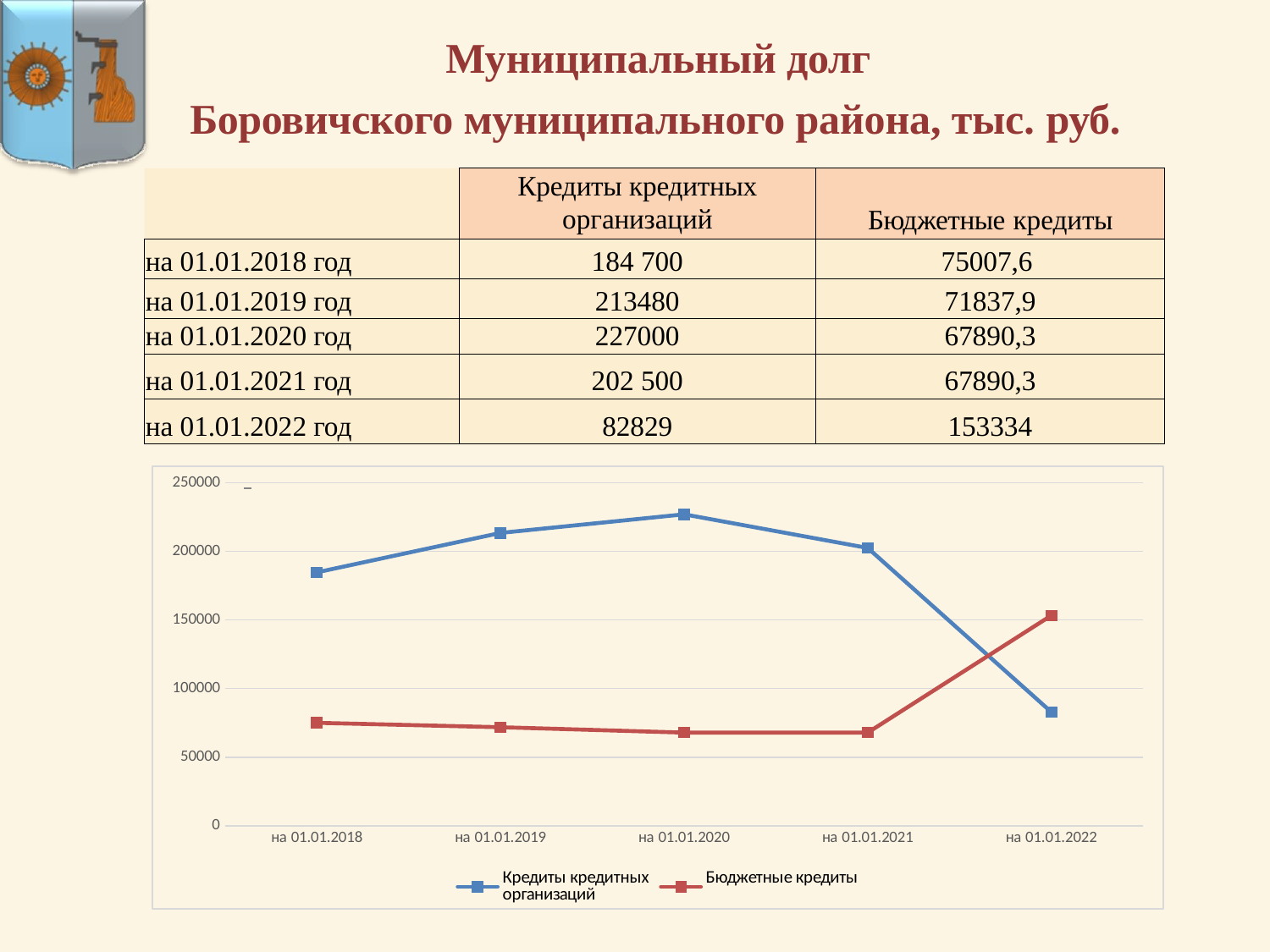
At which date is Кредиты кредитных организаций highest? на 01.01.2020 How many dates are plotted along the x axis of the chart? 5 What is the value of Бюджетные кредиты на 01.01.2022? 153334 Which series has the larger value на 01.01.2022? Бюджетные кредиты What kind of chart is shown on the slide? line chart What is the difference between Кредиты кредитных организаций and Бюджетные кредиты на 01.01.2022? 70505 Is the value of Бюджетные кредиты на 01.01.2019 greater or less than 100000? less Is the value of Кредиты кредитных организаций на 01.01.2021 greater or less than 200000? greater At which date is Кредиты кредитных организаций lowest? на 01.01.2022 How many series does the chart legend list? 2 What is the value of Кредиты кредитных организаций на 01.01.2020? 227000 Does the Бюджетные кредиты series rise or fall between 01.01.2021 and 01.01.2022? rise